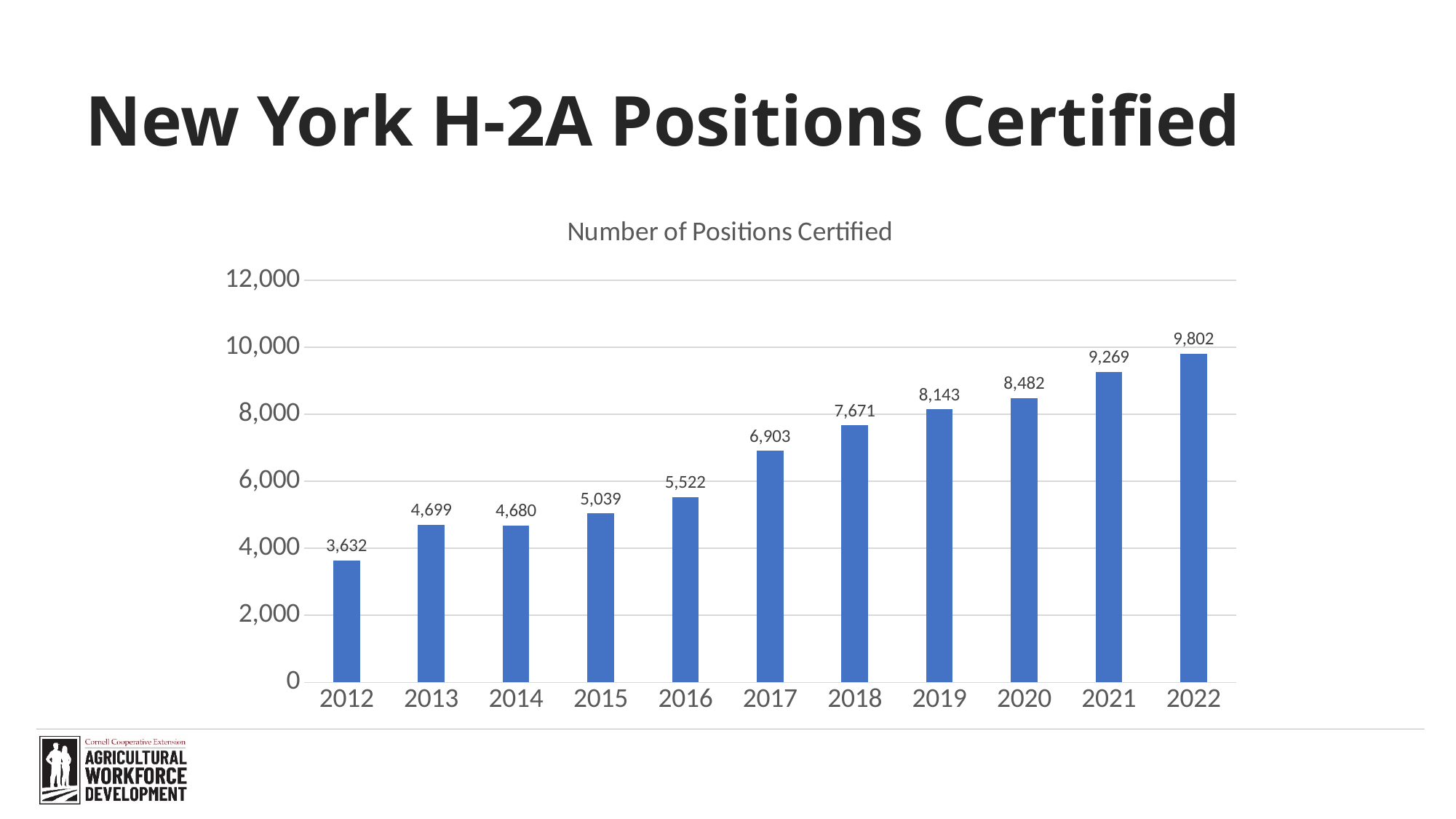
How many years are shown on the x axis? 11 What is the difference between the number of positions certified in 2013 and in 2014? 19 What is the number of positions certified in 2022? 9,802 Which year has the lowest number of positions certified? 2012 What is the difference between the number of positions certified in 2022 and in 2021? 533 What is the title of the chart? Number of Positions Certified Which year has more positions certified, 2016 or 2017? 2017 Which year has the highest number of positions certified? 2022 What is the number of positions certified in 2012? 3,632 What is the number of positions certified in 2018? 7,671 What kind of chart is shown on the slide? Bar chart Is the value for 2019 greater or less than 8,000? greater